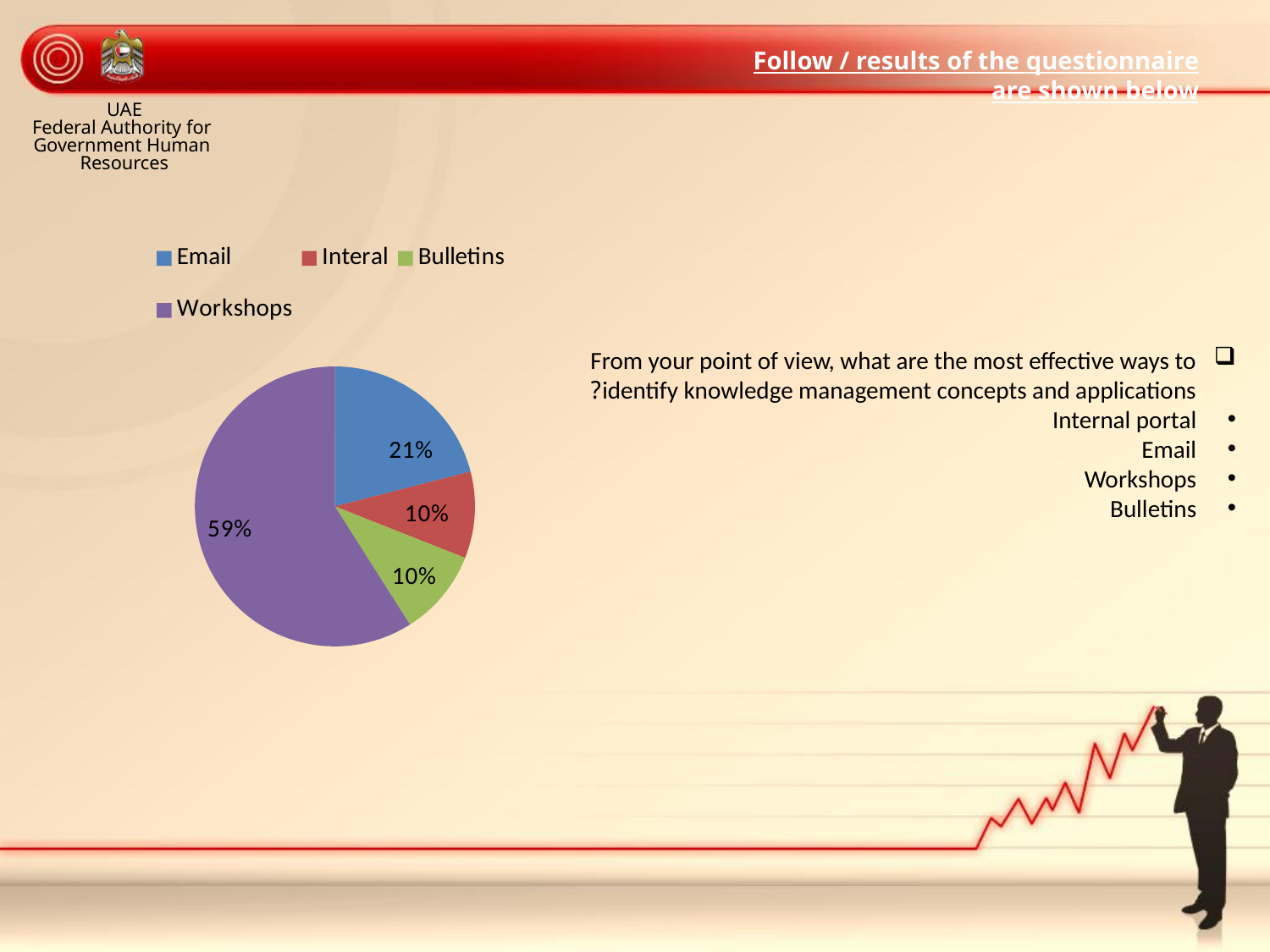
Which legend entry is shown in blue? Email How many entries does the legend list? 4 What kind of chart is shown on the slide? pie chart Which is larger, the slice for Email or the slice for Bulletins? Email Which category has the largest slice of the pie? Workshops What colour is the Workshops slice in the pie chart? purple What share of the pie does Email take? 21% What share of the pie does Workshops take? 59% How many slices does the pie chart have? 4 What is the difference between the Workshops share and the Email share? 38% What share of the pie does Bulletins take? 10% What share of the pie does Interal take? 10%